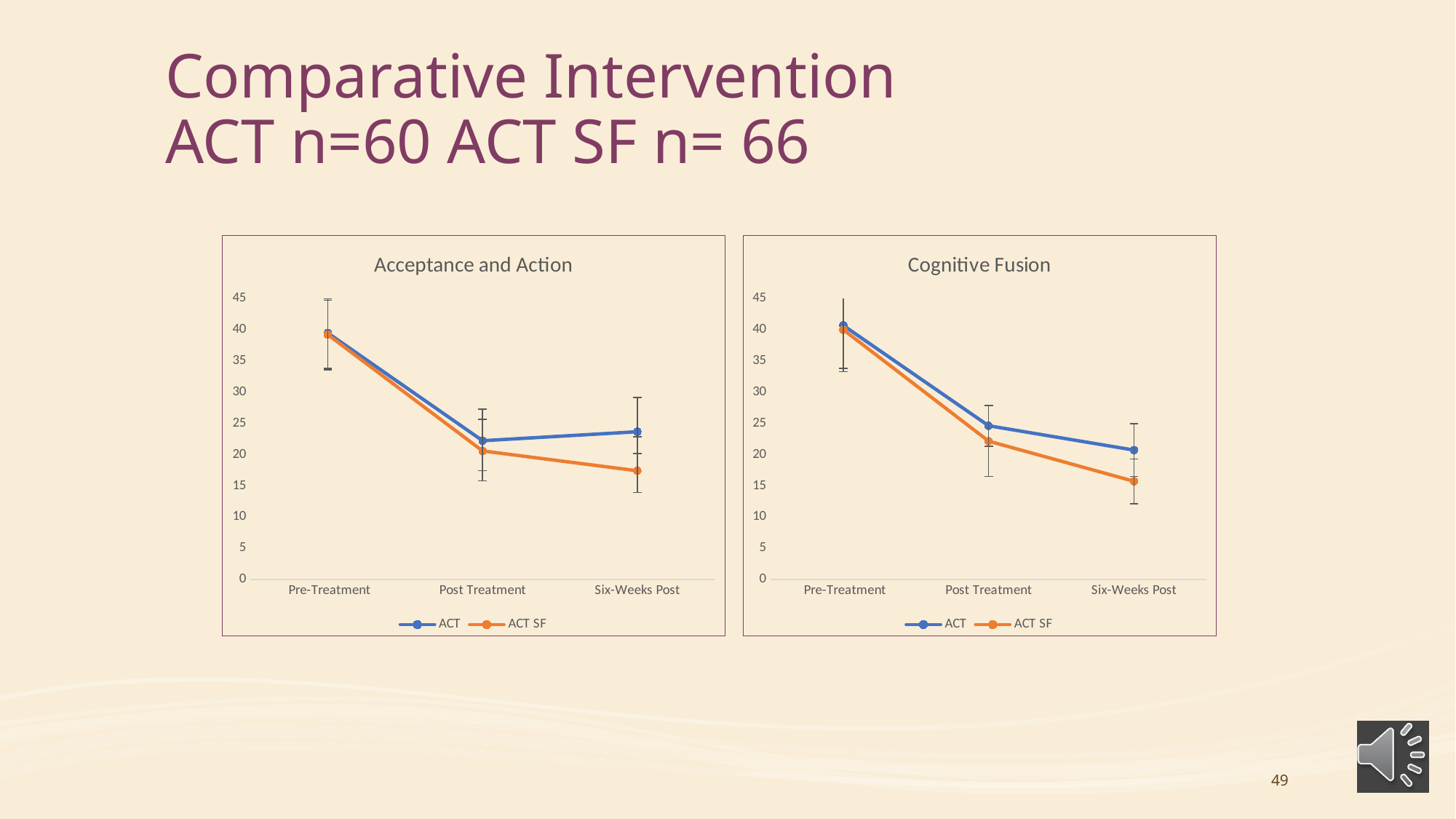
In the "Acceptance and Action" chart, at which time point is the ACT SF series lowest? Six-Weeks Post In the "Cognitive Fusion" chart, is the ACT SF value at Six-Weeks Post greater or less than 20? less What are the two series names listed in the legend of the "Acceptance and Action" chart? ACT and ACT SF In the "Cognitive Fusion" chart, does the ACT SF series rise or fall from Pre-Treatment to Six-Weeks Post? fall How many series does the legend of the "Cognitive Fusion" chart list? 2 How many time points are shown on the x axis of the "Acceptance and Action" chart? 3 In the "Cognitive Fusion" chart, which series has the higher value at Six-Weeks Post, ACT or ACT SF? ACT In the "Acceptance and Action" chart, is the ACT value at Pre-Treatment greater or less than 35? greater In the "Cognitive Fusion" chart, is the ACT value at Post Treatment greater or less than 20? greater In the "Acceptance and Action" chart, which series has the higher value at Six-Weeks Post, ACT or ACT SF? ACT What kind of chart is the "Acceptance and Action" chart? line chart